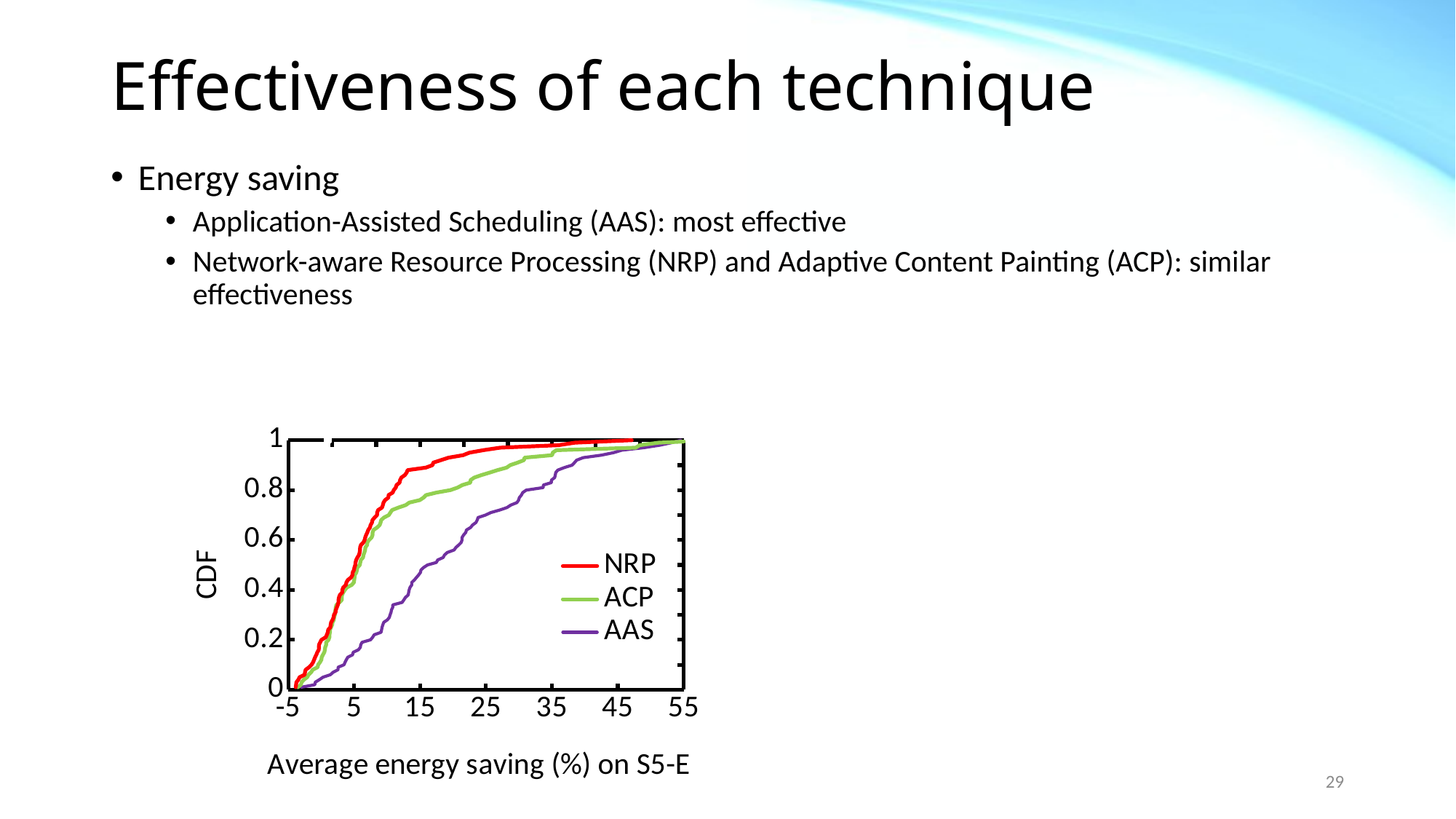
At an average energy saving of 15%, which series has the higher CDF value, NRP or AAS? NRP At an average energy saving of 25%, which series has the lower CDF value, ACP or AAS? AAS How many series does the legend list? 3 At an average energy saving of 15%, is the CDF value for NRP greater or less than 0.8? greater At an average energy saving of 15%, is the CDF value for AAS greater or less than 0.6? less Which series reaches a CDF of 0.8 at the lowest average energy saving? NRP What is the label of the x axis? Average energy saving (%) on S5-E What kind of chart is shown on the slide? line chart Which colour is used for the AAS line? purple At an average energy saving of 25%, is the CDF value for AAS greater or less than 0.6? greater Which series reaches a CDF of 0.8 at the highest average energy saving? AAS Do the CDF curves rise or fall as average energy saving increases along the x axis? rise